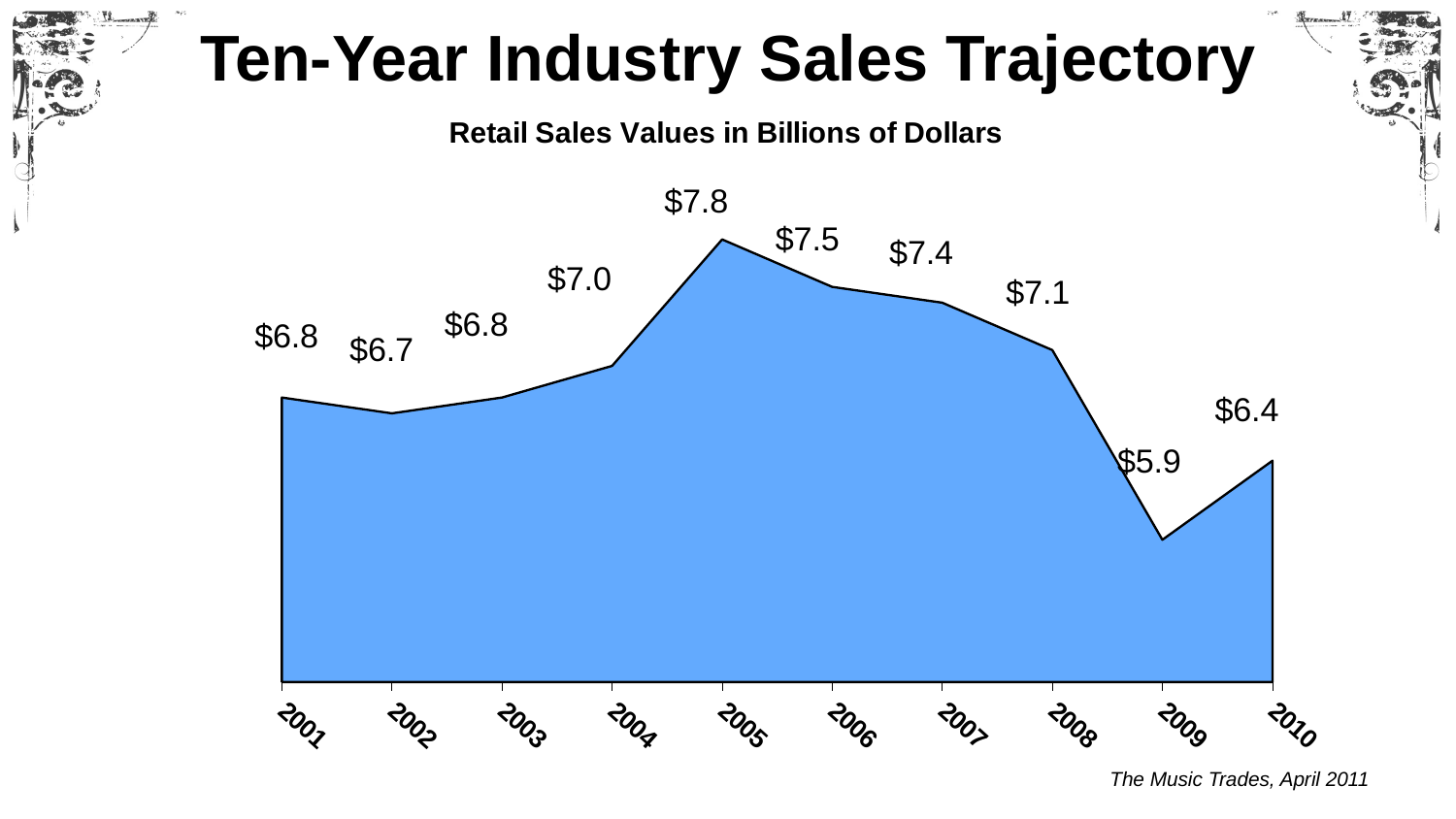
What kind of chart is shown on the slide? Area chart What is the difference between the retail sales values in 2005 and 2009? $1.9 How many years are plotted on the chart? 10 Did retail sales values rise or fall from 2005 to 2009? Fall What was the retail sales value in 2005? $7.8 Which year had the lowest retail sales value? 2009 What was the retail sales value in 2001? $6.8 What was the retail sales value in 2010? $6.4 What is the difference between the retail sales values in 2010 and 2009? $0.5 What was the retail sales value in 2009? $5.9 Which year had the highest retail sales value? 2005 Which year had a higher retail sales value, 2004 or 2008? 2008